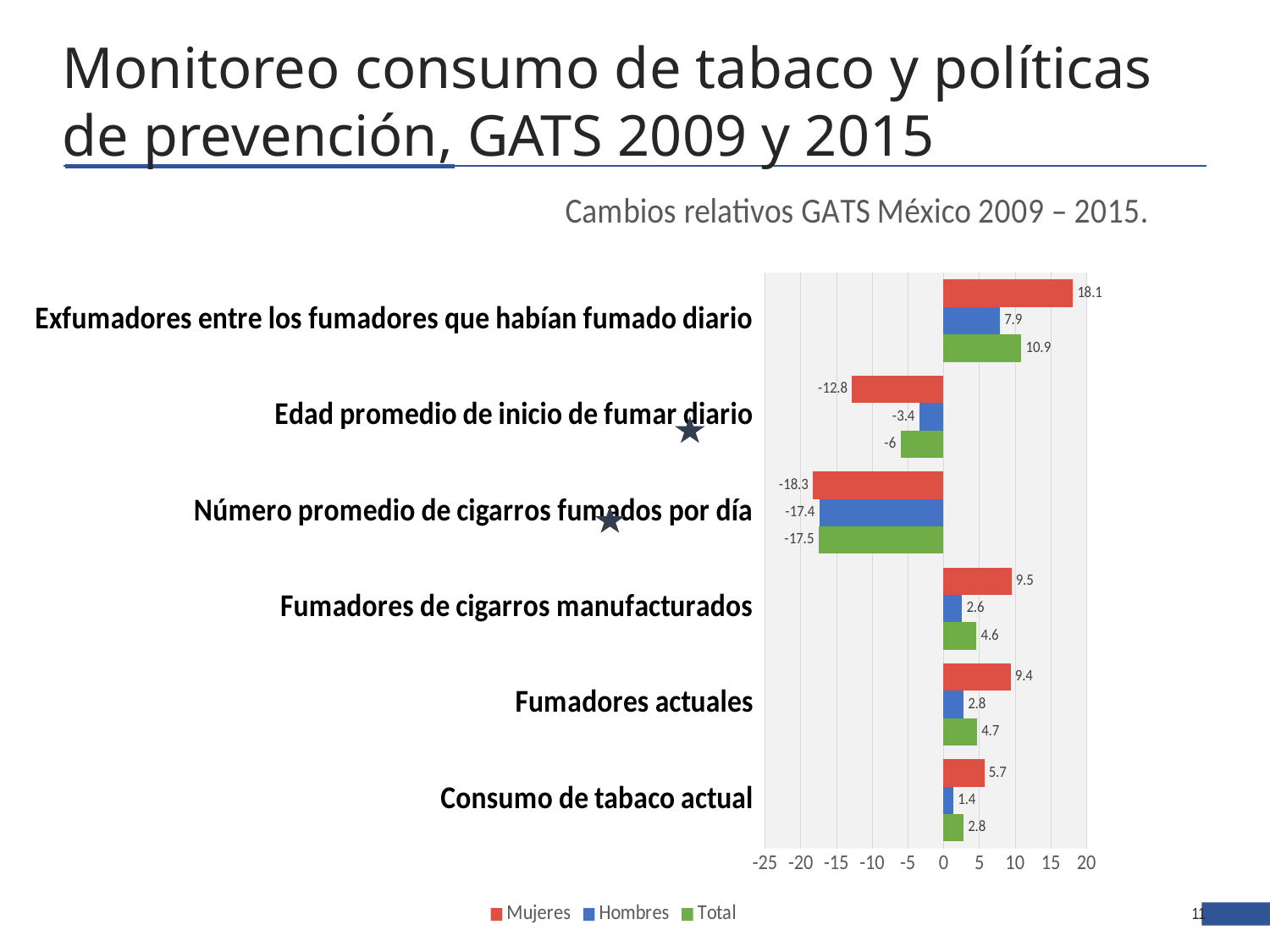
Which is larger for "Fumadores de cigarros manufacturados": the Mujeres value or the Total value? Mujeres Is the Mujeres value for "Número promedio de cigarros fumados por día" greater or less than -15? less What is the Total value for "Número promedio de cigarros fumados por día"? -17.5 What is the Hombres value for "Edad promedio de inicio de fumar diario"? -3.4 How many series does the legend list? 3 How many categories are shown on the chart? 6 What is the Hombres value for "Consumo de tabaco actual"? 1.4 What is the Mujeres value for "Exfumadores entre los fumadores que habían fumado diario"? 18.1 Which category has the lowest Total value? Número promedio de cigarros fumados por día What is the difference between the Mujeres and Hombres values for "Fumadores actuales"? 6.6 Which category has the highest Mujeres value? Exfumadores entre los fumadores que habían fumado diario What type of chart is shown on the slide? Bar chart